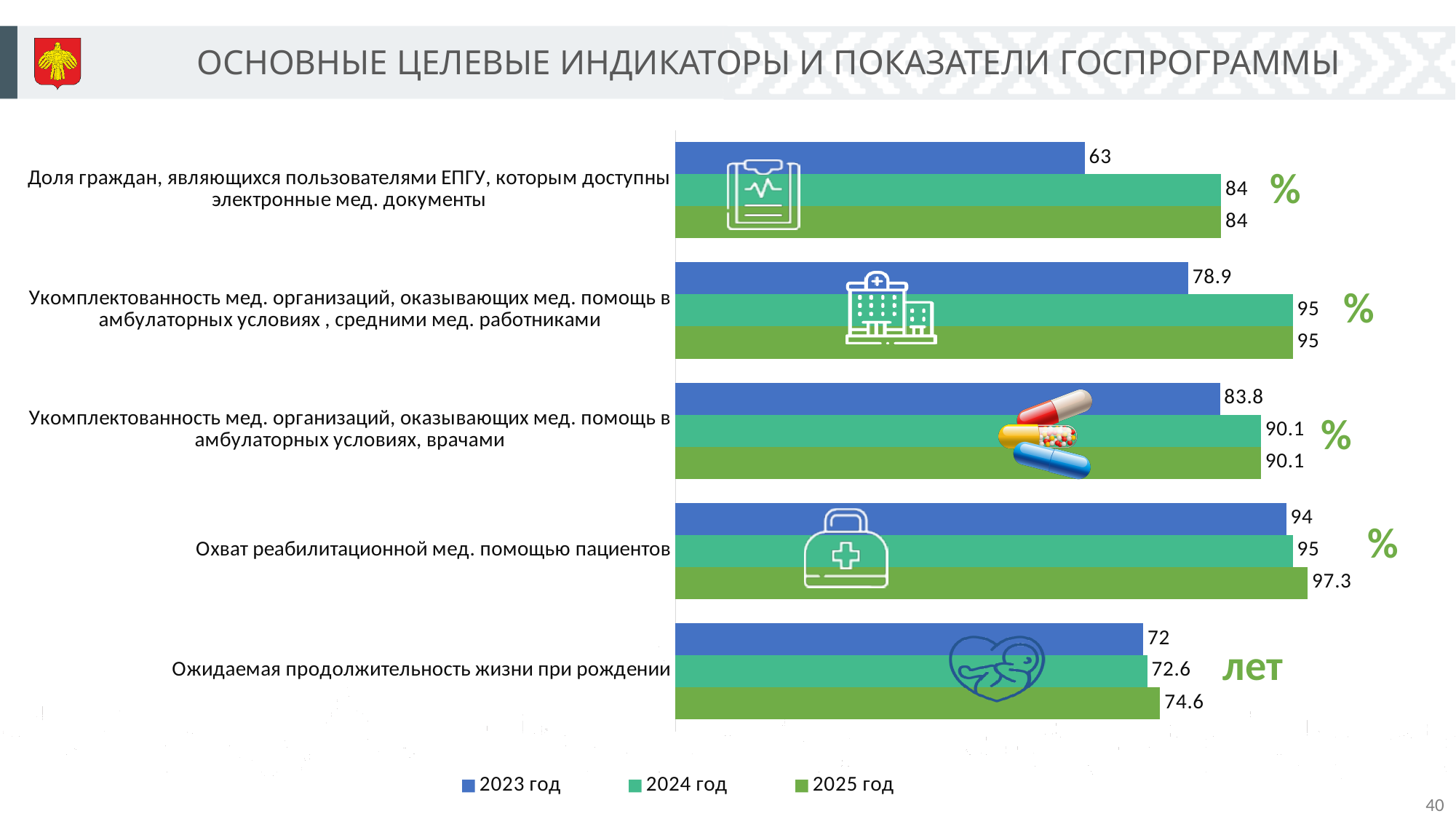
Каково значение показателя «Доля граждан, являющихся пользователями ЕПГУ, которым доступны электронные мед. документы» за 2023 год? 63 Каково значение показателя «Ожидаемая продолжительность жизни при рождении» за 2025 год? 74.6 На сколько значение показателя «Охват реабилитационной мед. помощью пациентов» за 2025 год больше значения за 2023 год? 3.3 У какого показателя самое низкое значение за 2023 год? Доля граждан, являющихся пользователями ЕПГУ, которым доступны электронные мед. документы Как меняется значение показателя «Ожидаемая продолжительность жизни при рождении» с 2023 по 2025 год? Растёт Сколько показателей (категорий) представлено на диаграмме? 5 Каково значение показателя «Укомплектованность мед. организаций, оказывающих мед. помощь в амбулаторных условиях, врачами» за 2024 год? 90.1 Сколько рядов данных указано в легенде диаграммы? 3 На сколько значение показателя «Доля граждан, являющихся пользователями ЕПГУ, которым доступны электронные мед. документы» за 2024 год больше значения за 2023 год? 21 У какого показателя самое высокое значение за 2023 год? Охват реабилитационной мед. помощью пациентов Какого типа диаграмма представлена на слайде? Столбчатая (bar chart) Какой показатель за 2023 год выше: укомплектованность средними мед. работниками или укомплектованность врачами? Укомплектованность врачами